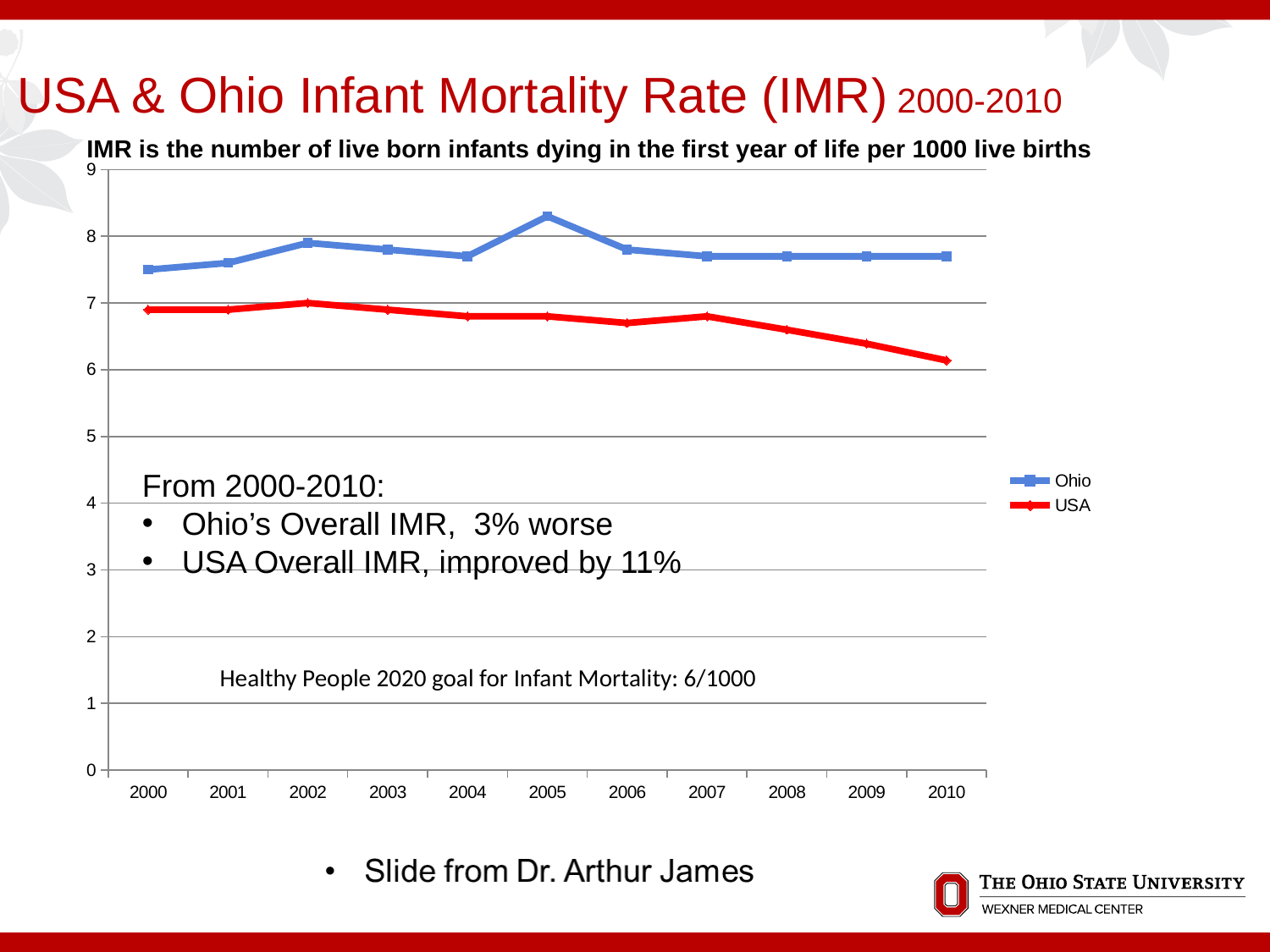
How many series does the legend list? 2 In 2005, which series has the higher value, Ohio or USA? Ohio Which colour is used for the USA series in the legend? red What kind of chart is shown on the slide? line chart In which year does the Ohio series reach its highest value? 2005 How many years are plotted along the x axis? 11 In which year does the USA series reach its lowest value? 2010 Is the value for Ohio in 2005 greater or less than 8? greater Is the value for Ohio in 2000 greater or less than 7? greater Does the USA series rise or fall overall from 2000 to 2010? fall Is the value for USA in 2008 greater or less than 7? less